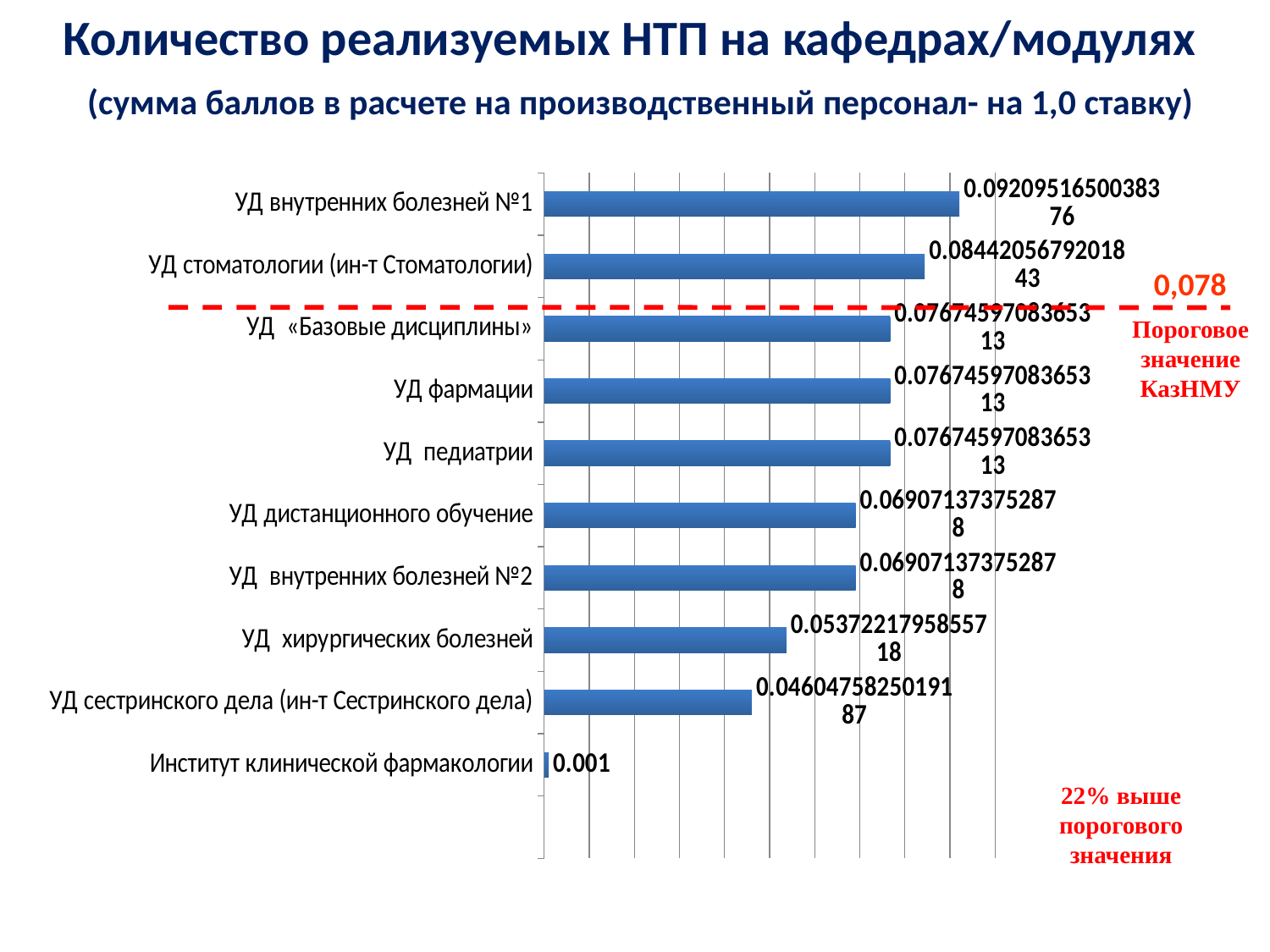
What is the value shown for Институт клинической фармакологии? 0.001 Do the bar values increase or decrease going from the top of the chart to the bottom? decrease Which department has the lowest value in the chart? Институт клинической фармакологии How many departments (categories) are plotted in the chart? 10 Which department has the highest value in the chart? УД внутренних болезней №1 What type of chart is shown on the slide? bar chart What is the value shown for УД внутренних болезней №1? 0.0920951650038376 How many bars lie above the red dashed threshold line? 2 Which is larger: the value for УД дистанционного обучение or the value for УД сестринского дела (ин-т Сестринского дела)? УД дистанционного обучение What threshold value (Пороговое значение КазНМУ) is marked by the red dashed line? 0,078 What is the value shown for УД хирургических болезней? 0.0537221795855718 What is the value shown for УД стоматологии (ин-т Стоматологии)? 0.0844205679201843